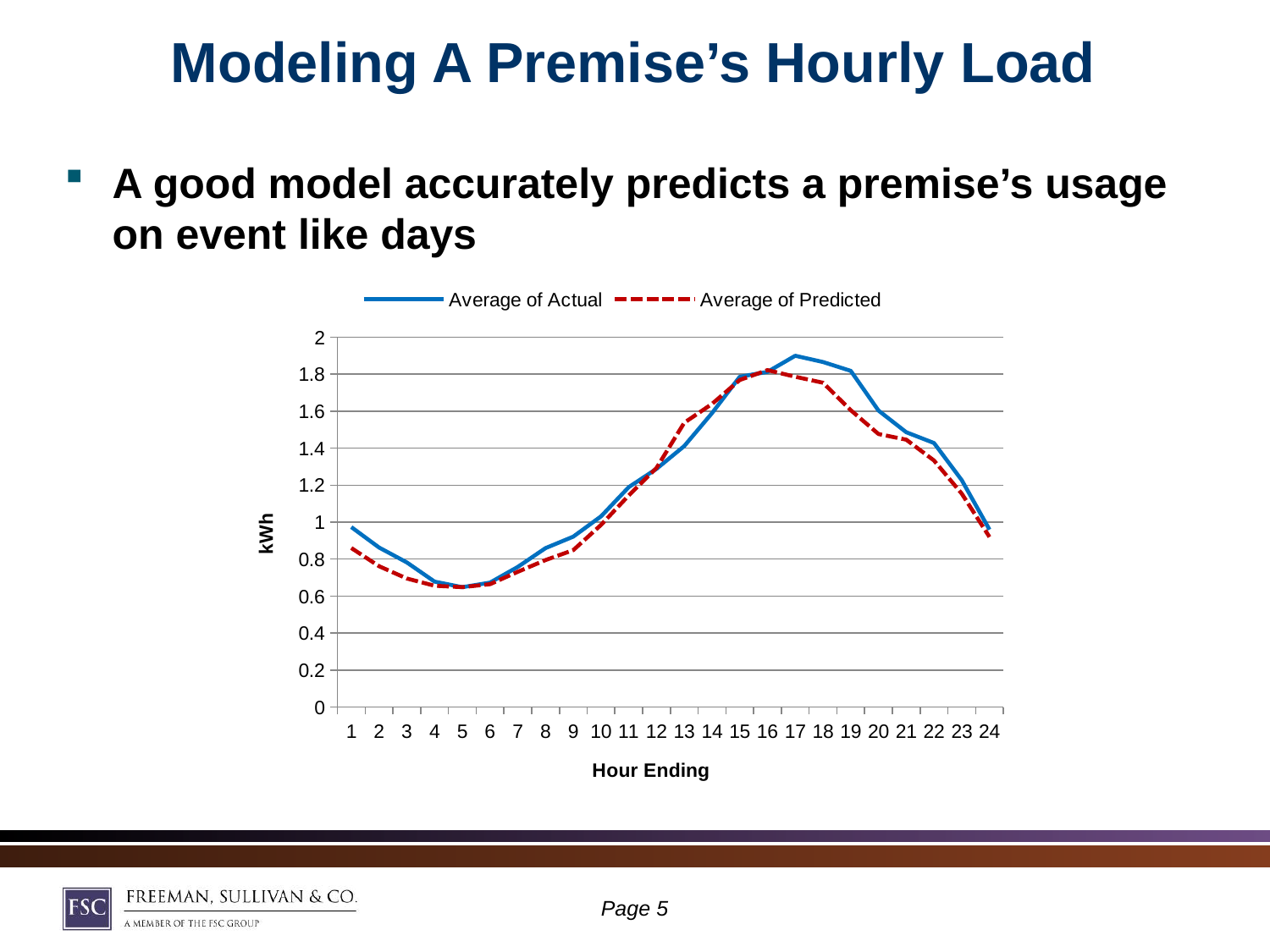
What is the label on the chart's vertical axis? kWh How many hours are plotted along the x axis of the chart? 24 Does the Average of Actual series rise or fall from hour ending 17 to hour ending 24? fall At hour ending 13, which series has the larger value, Average of Actual or Average of Predicted? Average of Predicted Is the Average of Predicted value at hour ending 13 greater or less than 1.4? greater What kind of chart is shown on the slide? line chart Is the Average of Actual value at hour ending 5 greater or less than 0.8? less Is the Average of Predicted value at hour ending 20 greater or less than 1.6? less How many series does the chart's legend list? 2 At which hour ending does the Average of Actual series reach its highest value? 17 At hour ending 19, which series has the larger value, Average of Actual or Average of Predicted? Average of Actual